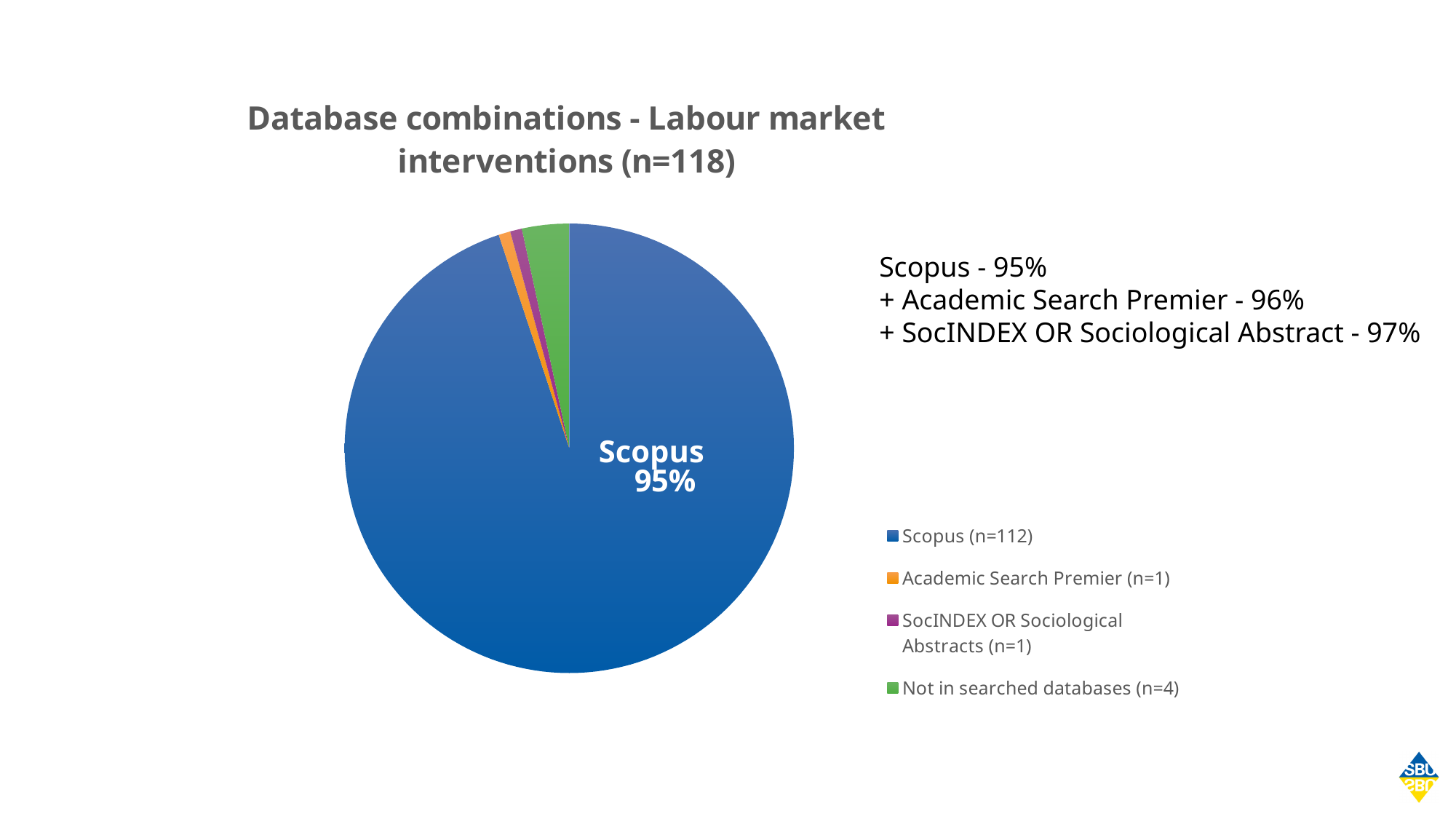
How many records are in the Scopus category according to the legend? 112 How many records are in the 'Not in searched databases' category according to the legend? 4 What is the difference in record count between Scopus (n=112) and Not in searched databases (n=4)? 108 What share of the pie does Scopus account for? 95% Which is larger, the 'Not in searched databases' slice or the Academic Search Premier slice? Not in searched databases What kind of chart is shown on the slide? pie chart What is the title of the chart? Database combinations - Labour market interventions (n=118) What is the total n stated in the chart title? 118 How many records are in the Academic Search Premier category according to the legend? 1 Which category has the largest slice of the pie? Scopus How many slices does the pie chart have? 4 What colour is the Scopus slice? blue